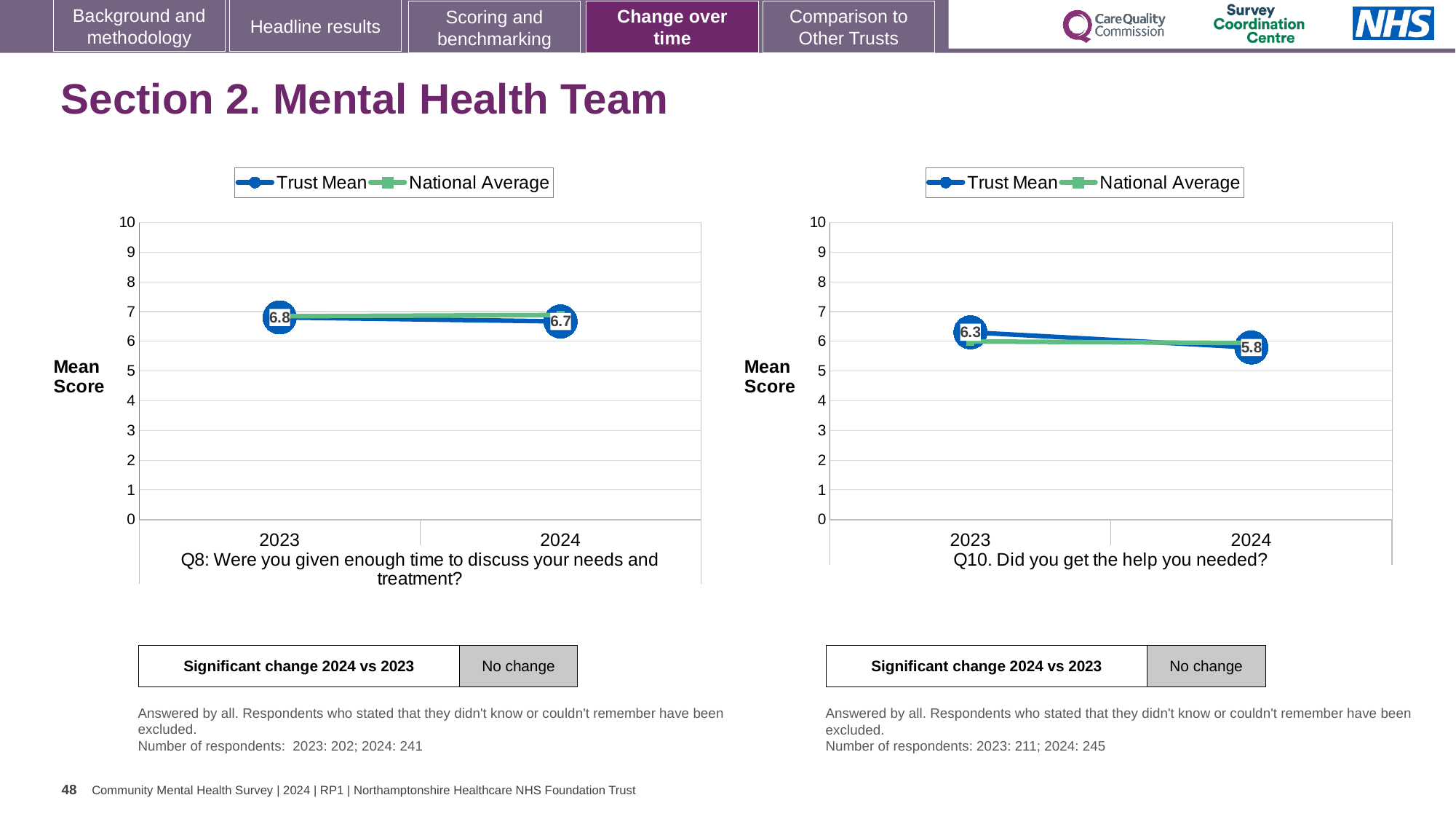
In the Q8 chart (left), what is the difference between the Trust Mean scores for 2023 and 2024? 0.1 In the Q8 chart (left), what is the Trust Mean score for 2024? 6.7 In the Q10 chart (right), which year has the higher Trust Mean score, 2023 or 2024? 2023 How many years are plotted on the x axis of the Q8 chart (left)? 2 In the Q8 chart (left), is the National Average value for 2023 greater or less than 5? greater In the Q10 chart (right), what is the Trust Mean score for 2023? 6.3 In the Q10 chart (right), by how much did the Trust Mean score fall from 2023 to 2024? 0.5 In the Q10 chart (right), what is the Trust Mean score for 2024? 5.8 In the Q10 chart (right), does the Trust Mean rise or fall from 2023 to 2024? fall In the Q8 chart (left), what is the Trust Mean score for 2023? 6.8 What kind of chart is the Q10 chart (right)? line chart How many series does the legend of the Q8 chart (left) list? 2